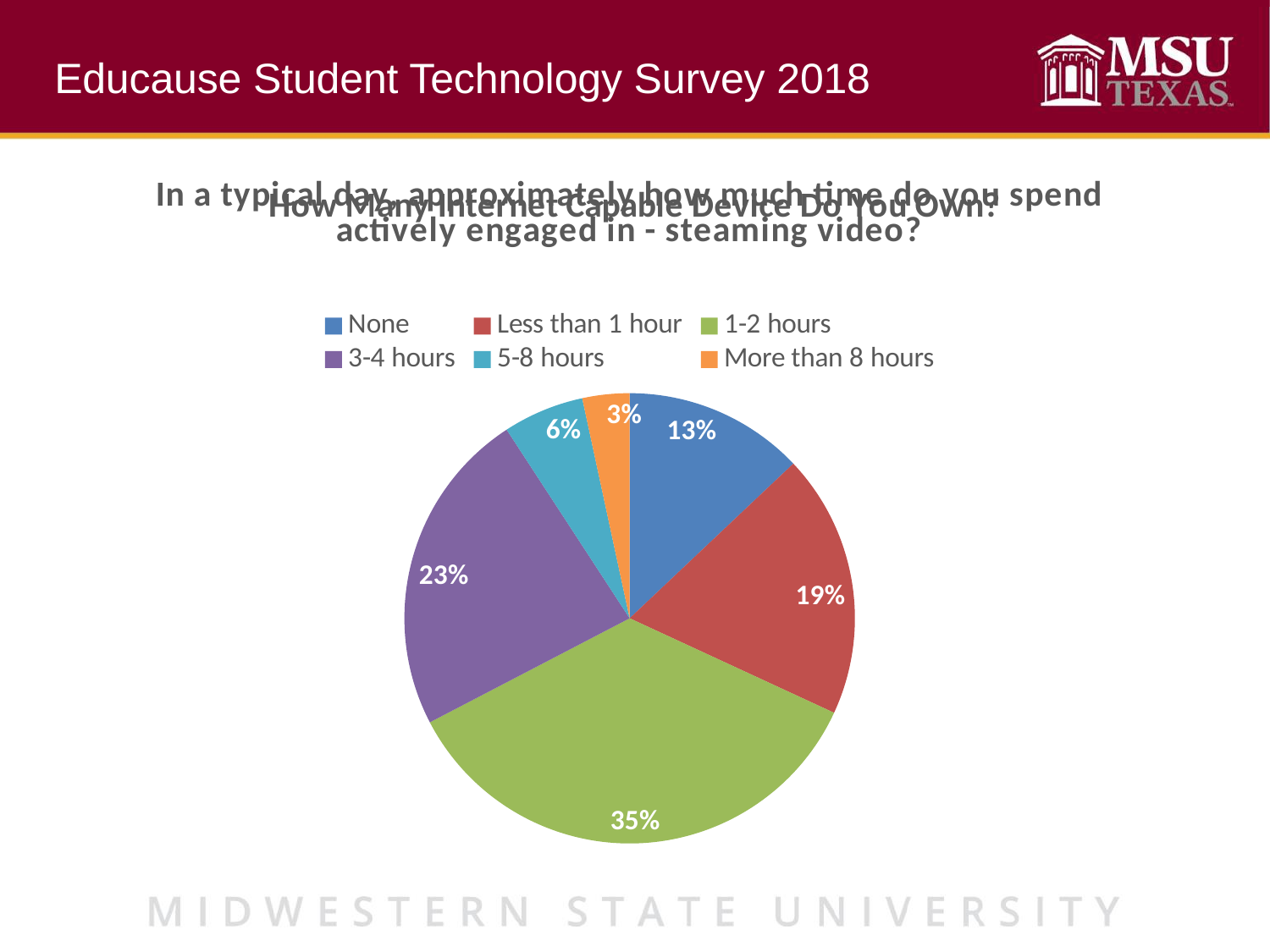
What is the difference in percentage points between the "1-2 hours" slice and the "Less than 1 hour" slice? 16 What percentage is shown for the "None" slice? 13% How many categories does the legend list? 6 What kind of chart is shown on the slide? Pie chart What percentage is shown for the "3-4 hours" slice? 23% What percentage is shown for the "5-8 hours" slice? 6% What colour is the "1-2 hours" slice in the pie chart? Green What percentage is shown for the "More than 8 hours" slice? 3% Which category has the largest share of the pie? 1-2 hours What percentage of the pie is labelled for the "1-2 hours" slice? 35% Which slice is larger, "3-4 hours" or "Less than 1 hour"? 3-4 hours Which category has the smallest share of the pie? More than 8 hours